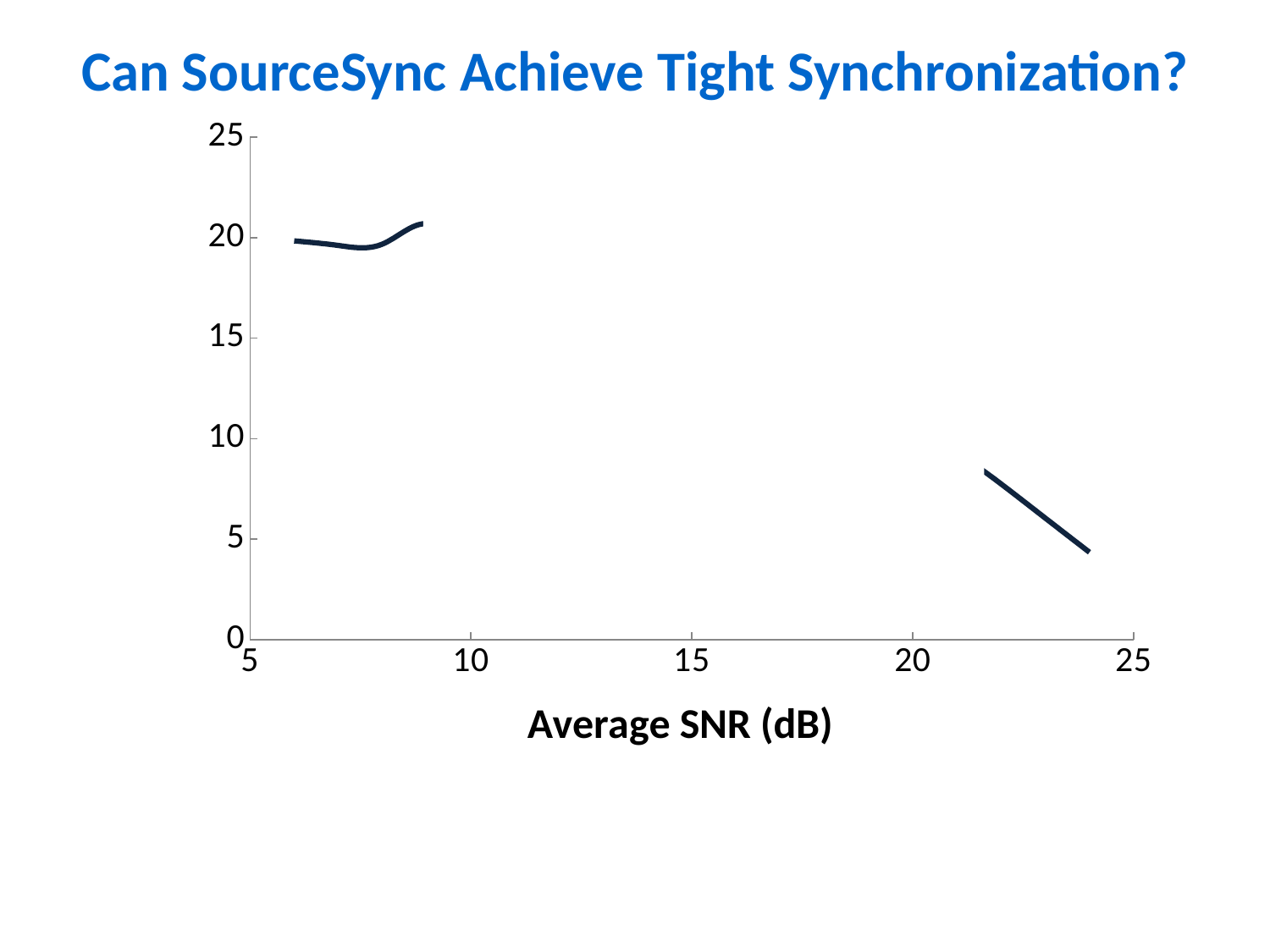
What kind of chart is shown on the slide? line chart Is the plotted value at an average SNR of about 22 dB greater or less than 5? greater How many separate line segments are plotted on the chart? 2 Is the plotted value at an average SNR of about 6 dB greater or less than 15? greater Is the plotted value at an average SNR of about 24 dB greater or less than 10? less What is the title of the slide? Can SourceSync Achieve Tight Synchronization? Do the plotted values rise or fall as the average SNR increases from about 22 dB to 24 dB? fall Which is larger: the plotted value at an average SNR of about 6 dB or at about 24 dB? about 6 dB What is the label of the x axis? Average SNR (dB)